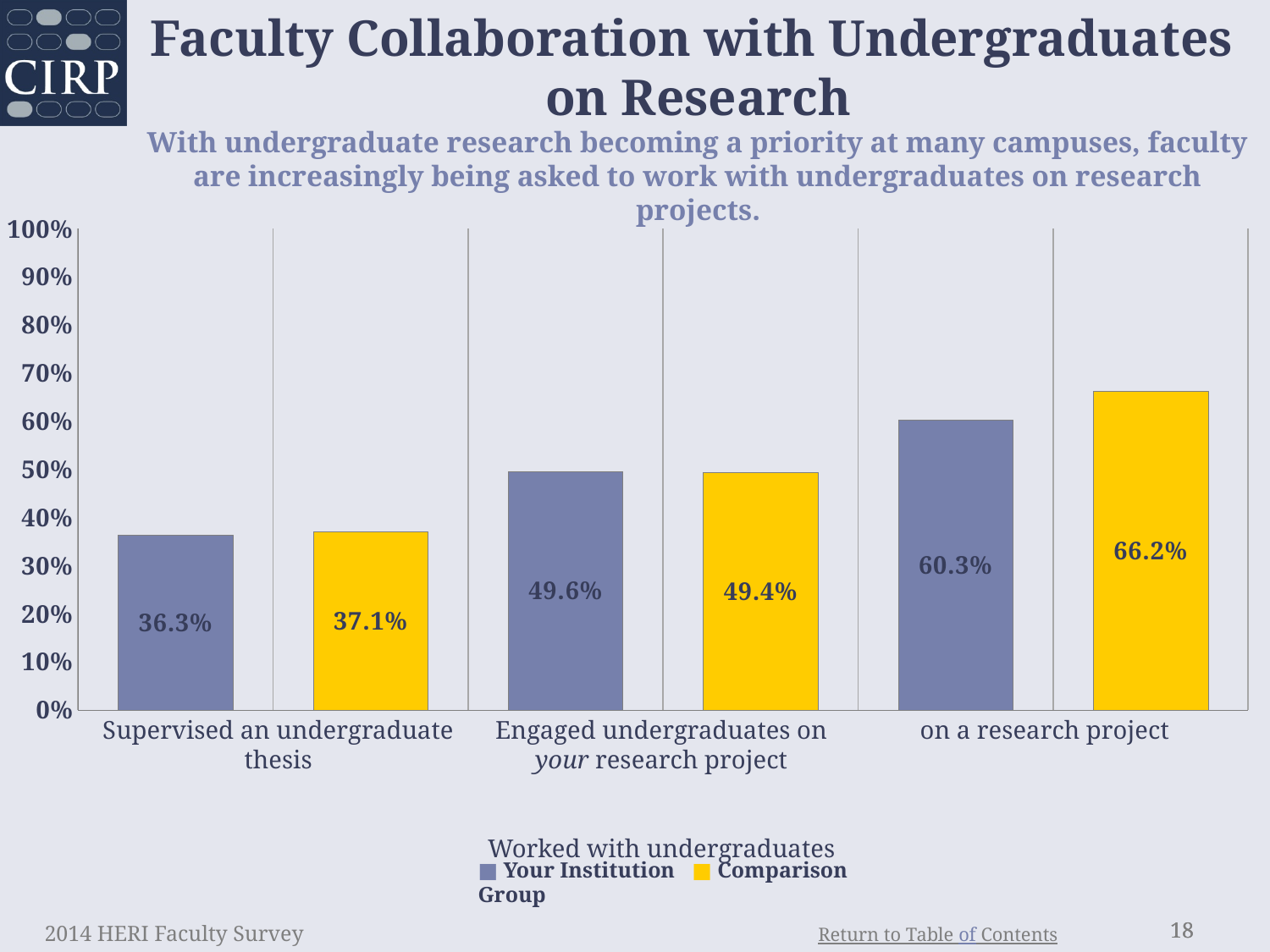
What kind of chart is shown on the slide? bar chart For 'Worked with undergraduates on a research project', which is larger: Your Institution or the Comparison Group? Comparison Group How many categories are shown on the x axis? 3 What is the value for the Comparison Group for 'Supervised an undergraduate thesis'? 37.1% What is the value for Your Institution for 'Engaged undergraduates on your research project'? 49.6% What is the value for the Comparison Group for 'Worked with undergraduates on a research project'? 66.2% How many series does the legend list? 2 Which category has the lowest value for the Comparison Group? Supervised an undergraduate thesis Which category has the highest value for Your Institution? Worked with undergraduates on a research project What is the difference between the Comparison Group and Your Institution for 'Worked with undergraduates on a research project'? 5.9% Is the value for Your Institution for 'Engaged undergraduates on your research project' greater or less than 60%? less What is the value for Your Institution for 'Supervised an undergraduate thesis'? 36.3%